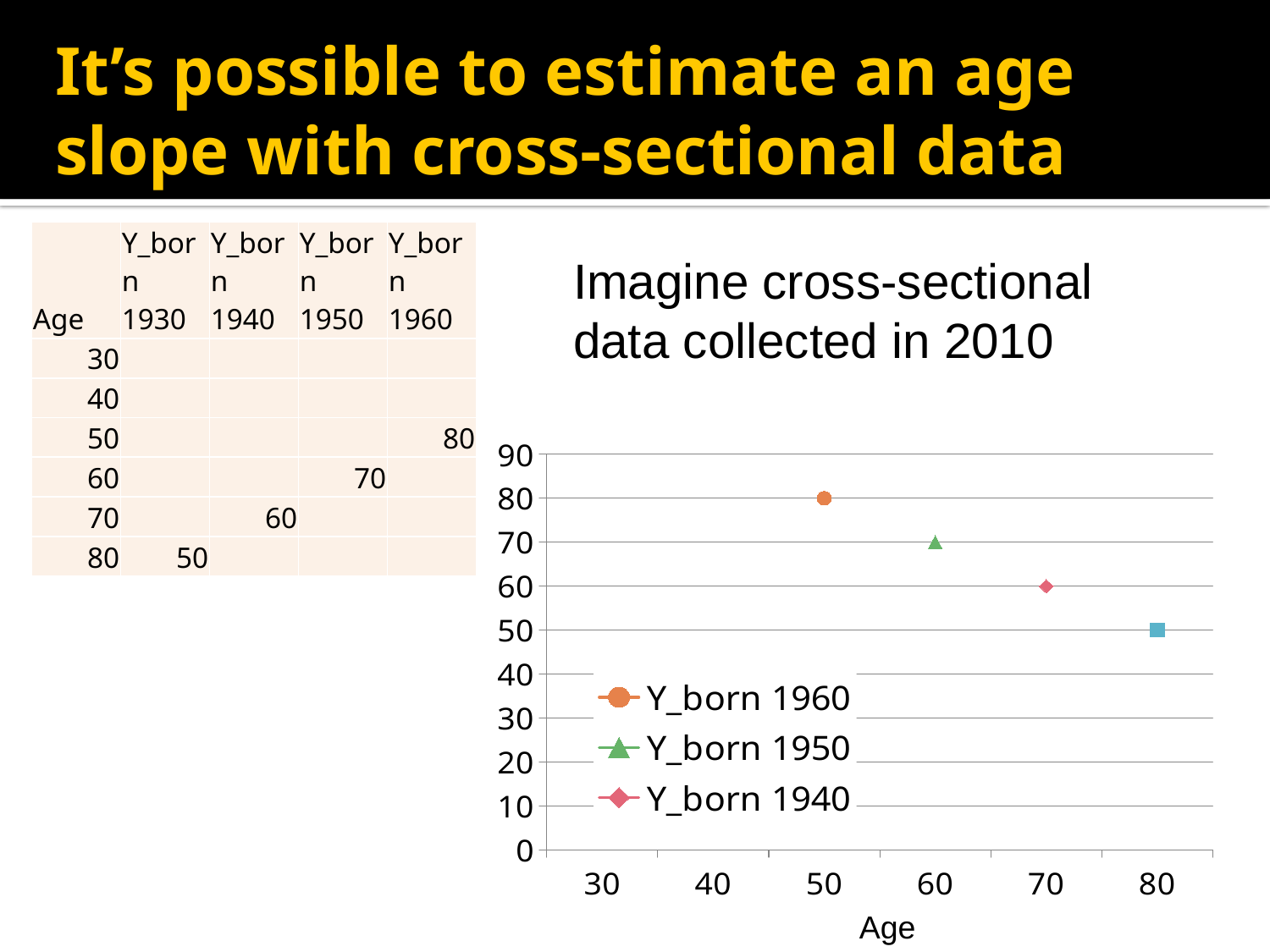
Is the value for Y_born 1940 at age 70 greater or less than 50? greater Do the plotted values rise or fall as age increases along the x axis? fall At which age is the lowest value plotted on the chart? 80 How many series does the chart legend list? 3 What is the plotted value for Y_born 1940 at age 70? 60 How many data points are plotted on the chart? 4 Which has the larger plotted value: the point at age 60 or the point at age 70? age 60 What kind of chart is shown on the slide? scatter chart What is the difference between the value plotted at age 50 and the value plotted at age 80? 30 At which age is the highest value plotted on the chart? 50 What is the plotted value for Y_born 1960 at age 50? 80 What is the plotted value for Y_born 1950 at age 60? 70